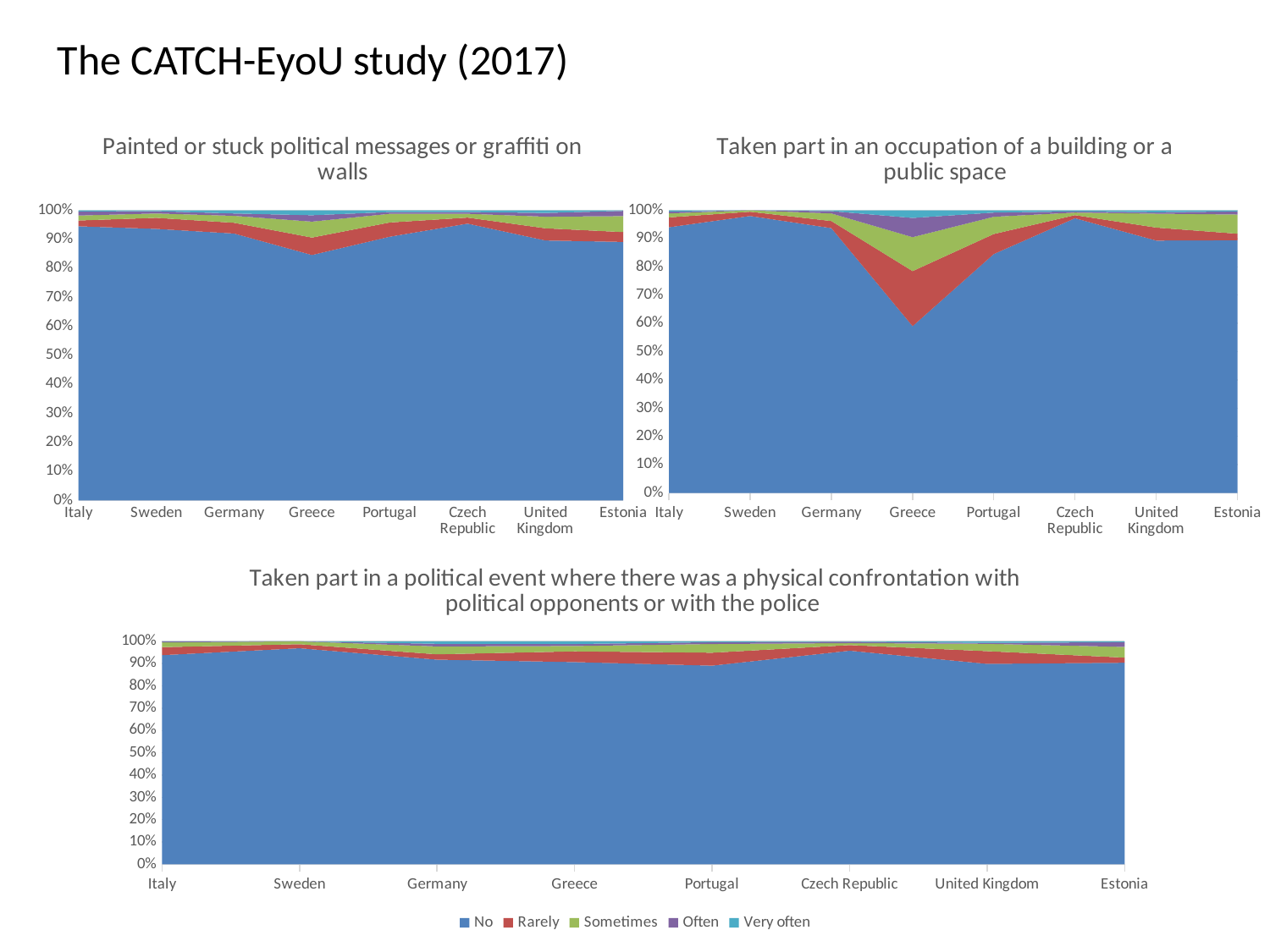
In the 'Taken part in an occupation of a building or a public space' chart, which has the larger 'No' share, Greece or Portugal? Portugal In the 'Painted or stuck political messages or graffiti on walls' chart, is the 'No' share for Italy greater or less than 90%? greater In the 'Taken part in an occupation of a building or a public space' chart, which country has the lowest share of 'No' responses? Greece Which series is shown in blue in the legend? No In the 'Painted or stuck political messages or graffiti on walls' chart, is the 'No' share for Greece greater or less than 90%? less How many series does the legend at the bottom of the slide list? 5 In the 'Taken part in an occupation of a building or a public space' chart, is the 'No' share for Greece greater or less than 50%? greater In the 'Painted or stuck political messages or graffiti on walls' chart, which country has the lowest share of 'No' responses? Greece How many countries are shown on the x axis of the 'Taken part in an occupation of a building or a public space' chart? 8 What kind of chart is the 'Painted or stuck political messages or graffiti on walls' chart? Stacked area chart